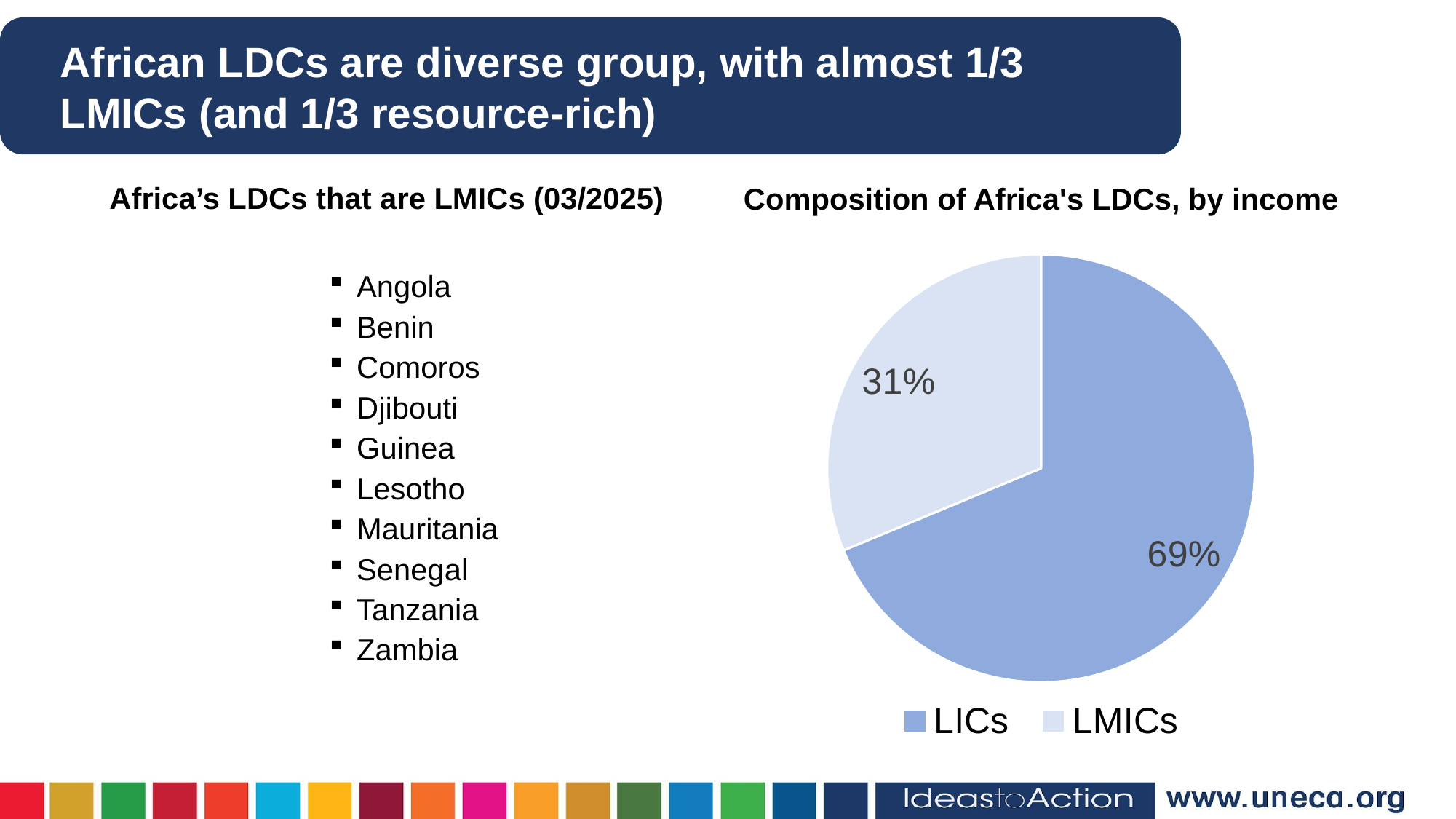
What share of Africa's LDCs are LICs according to the pie chart? 69% What is the title of the chart? Composition of Africa's LDCs, by income Which category has the largest slice in the pie chart? LICs Which is larger in the pie chart, LICs or LMICs? LICs What kind of chart is shown on the slide? pie chart What share of Africa's LDCs are LMICs according to the pie chart? 31% Which legend entry is shown in the lighter blue colour? LMICs What is the difference in percentage points between the LICs and LMICs slices? 38 How many slices does the pie chart have? 2 How many entries does the legend of the pie chart list? 2 Which category has the smallest slice in the pie chart? LMICs